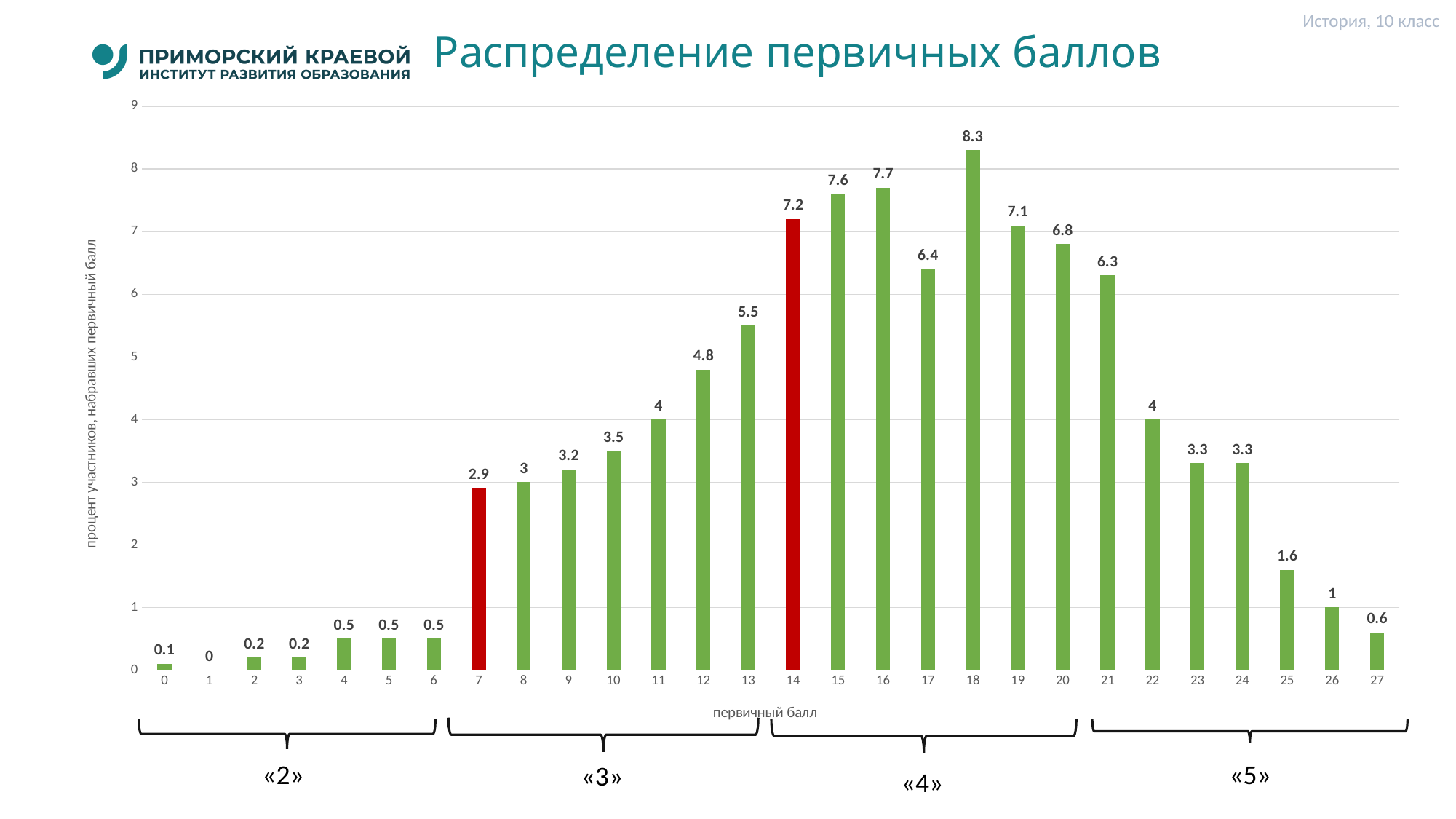
Which two primary scores are shown with red bars? 7 and 14 What kind of chart is shown on the slide? bar chart How many primary score categories are shown on the x axis? 28 Is the value for primary score 13 greater or less than 5? greater What is the value for primary score 7? 2.9 Do the values rise or fall from primary score 21 to primary score 27? fall What is the value for primary score 18? 8.3 What is the difference between the values for primary scores 18 and 14? 1.1 Which primary score has the highest percentage of participants? 18 Which primary score has the lowest percentage of participants? 1 What is the value for primary score 25? 1.6 Which is larger, the value for primary score 16 or for primary score 15? 16